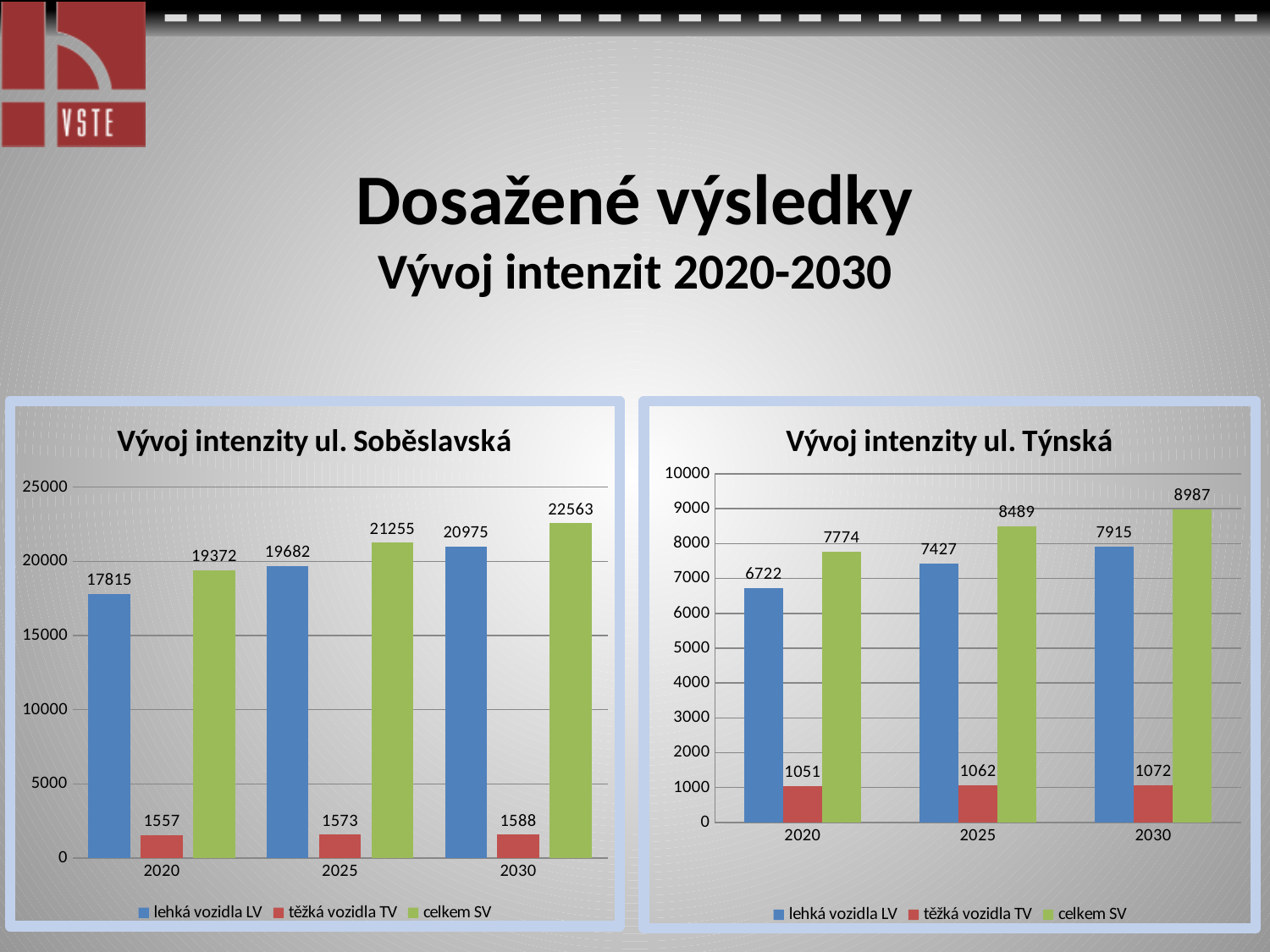
How many years are shown on the x axis of the chart 'Vývoj intenzity ul. Soběslavská'? 3 In the chart 'Vývoj intenzity ul. Soběslavská', what is the value for lehká vozidla LV in 2020? 17815 In the chart 'Vývoj intenzity ul. Soběslavská', what is the difference between the celkem SV values for 2030 and 2020? 3191 In the chart 'Vývoj intenzity ul. Soběslavská', which year has the lowest value for celkem SV? 2020 In the chart 'Vývoj intenzity ul. Týnská', which is larger: lehká vozidla LV in 2030 or celkem SV in 2025? celkem SV in 2025 In the chart 'Vývoj intenzity ul. Týnská', what is the difference between the lehká vozidla LV values for 2025 and 2020? 705 In the chart 'Vývoj intenzity ul. Týnská', do the celkem SV values rise or fall from 2020 to 2030? rise How many series does the legend of the chart 'Vývoj intenzity ul. Týnská' list? 3 In the chart 'Vývoj intenzity ul. Týnská', what is the value for celkem SV in 2030? 8987 In the chart 'Vývoj intenzity ul. Soběslavská', what is the value for těžká vozidla TV in 2025? 1573 In the chart 'Vývoj intenzity ul. Týnská', which year has the highest value for lehká vozidla LV? 2030 What kind of chart is 'Vývoj intenzity ul. Soběslavská'? bar chart